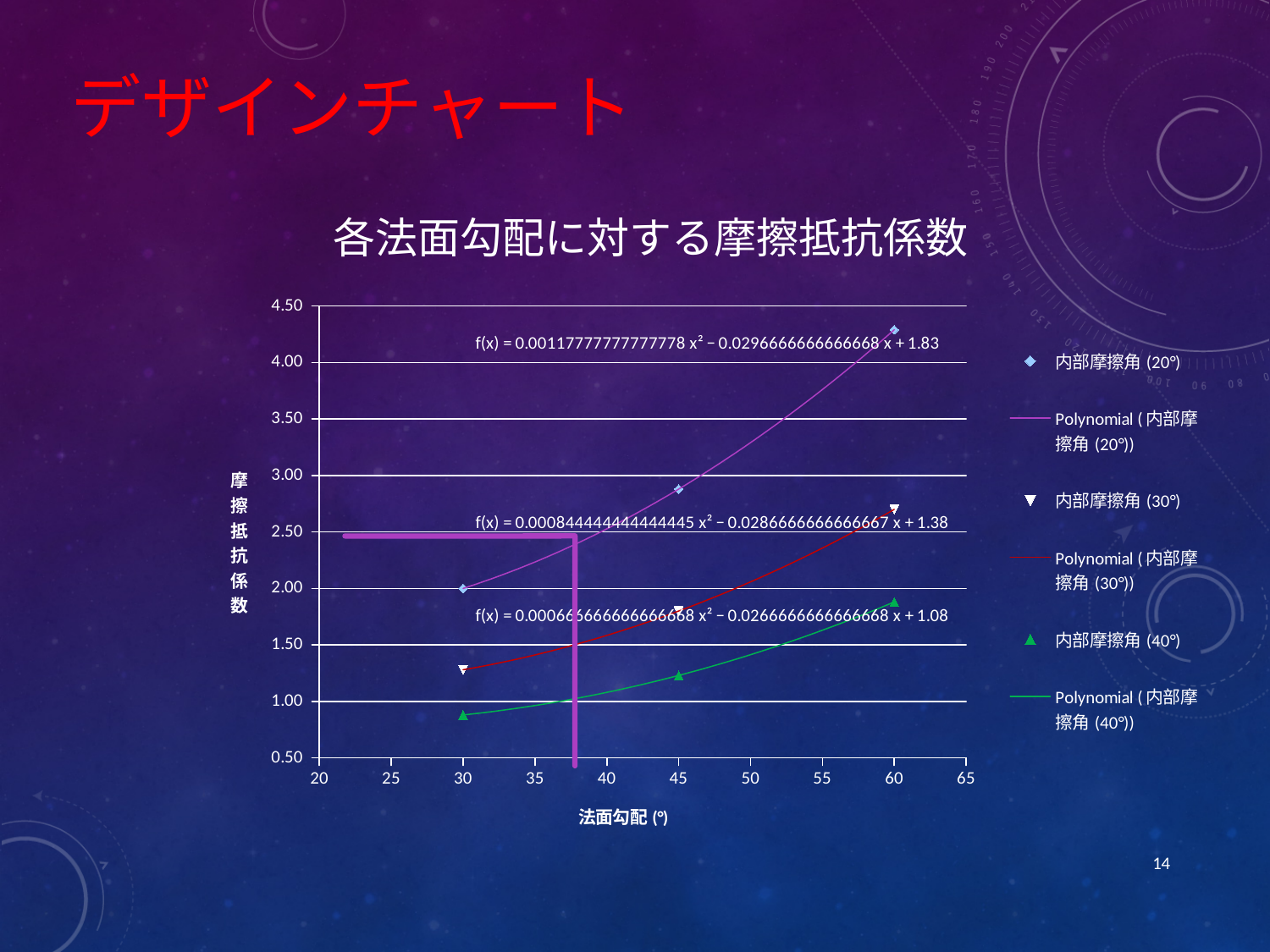
Is the value for 内部摩擦角 (40°) at 法面勾配 60 greater or less than 2.00? less What kind of chart is shown on the slide? scatter chart Which series has the lowest value at 法面勾配 30? 内部摩擦角 (40°) What is the label of the x axis? 法面勾配 (°) Which series has the highest value at 法面勾配 60? 内部摩擦角 (20°) Is the value for 内部摩擦角 (20°) at 法面勾配 60 greater or less than 4.00? greater Do the values of the 内部摩擦角 (30°) series rise or fall as 法面勾配 increases? rise How many entries does the chart legend list? 6 Is the value for 内部摩擦角 (30°) at 法面勾配 60 greater or less than 2.50? greater How many data points are plotted for the 内部摩擦角 (20°) series? 3 What is the title of the chart? 各法面勾配に対する摩擦抵抗係数